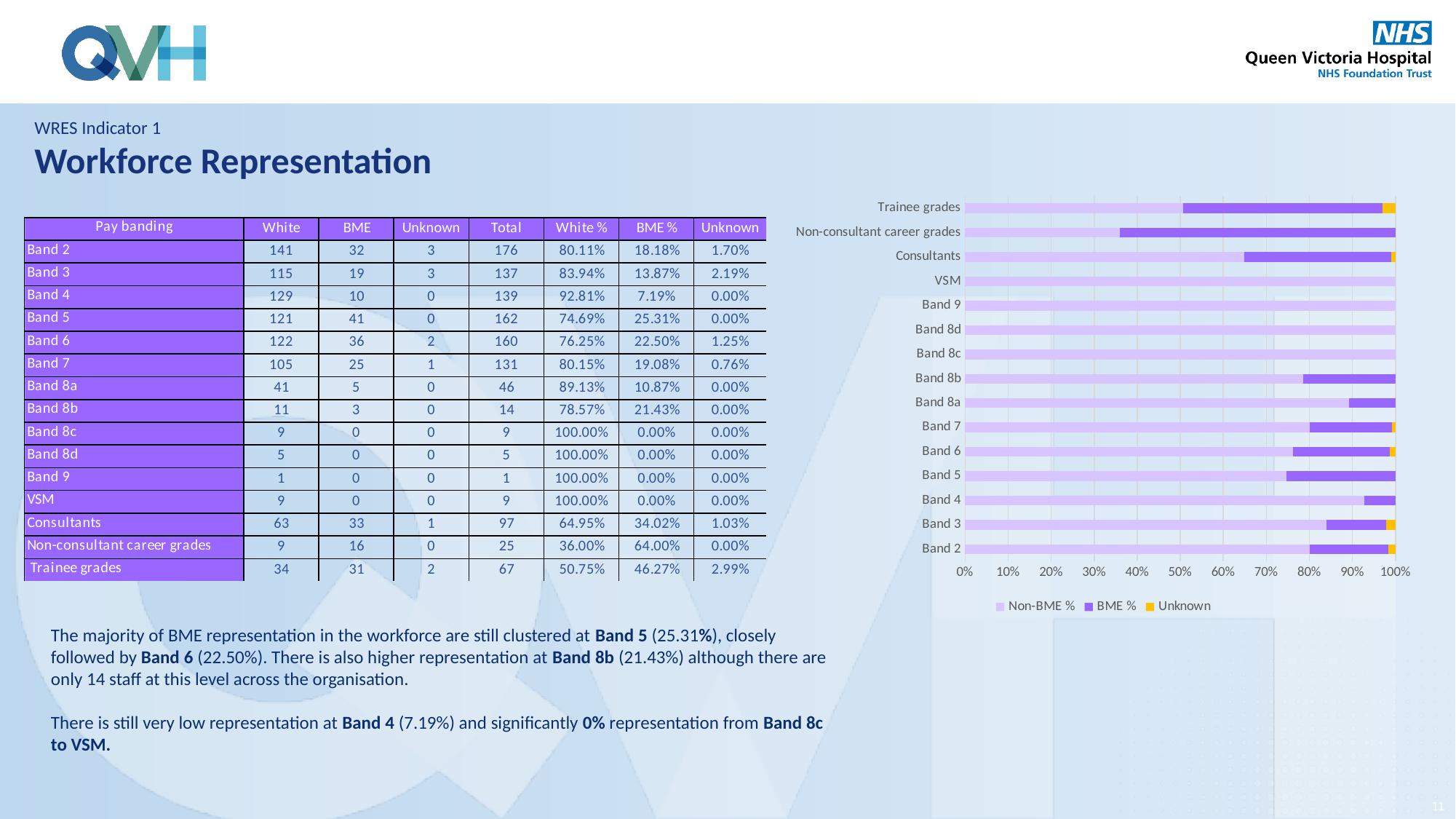
Which has the larger BME % share, Consultants or Band 2? Consultants What kind of chart is shown on the right of the slide? Bar chart According to the slide, what is the BME % for Band 5? 25.31% Is the Non-BME % value for Consultants greater or less than 70%? less Which category on the bar chart has the lowest Non-BME % share? Non-consultant career grades What colour represents the Unknown series in the bar chart's legend? Yellow According to the slide, what is the BME % for Trainee grades? 46.27% Is the Non-BME % value for Non-consultant career grades greater or less than 40%? less Which category on the bar chart has the highest BME % share? Non-consultant career grades How many series does the bar chart's legend list? 3 Is the Non-BME % value for Band 5 greater or less than 70%? greater How many pay banding categories are plotted on the bar chart? 15